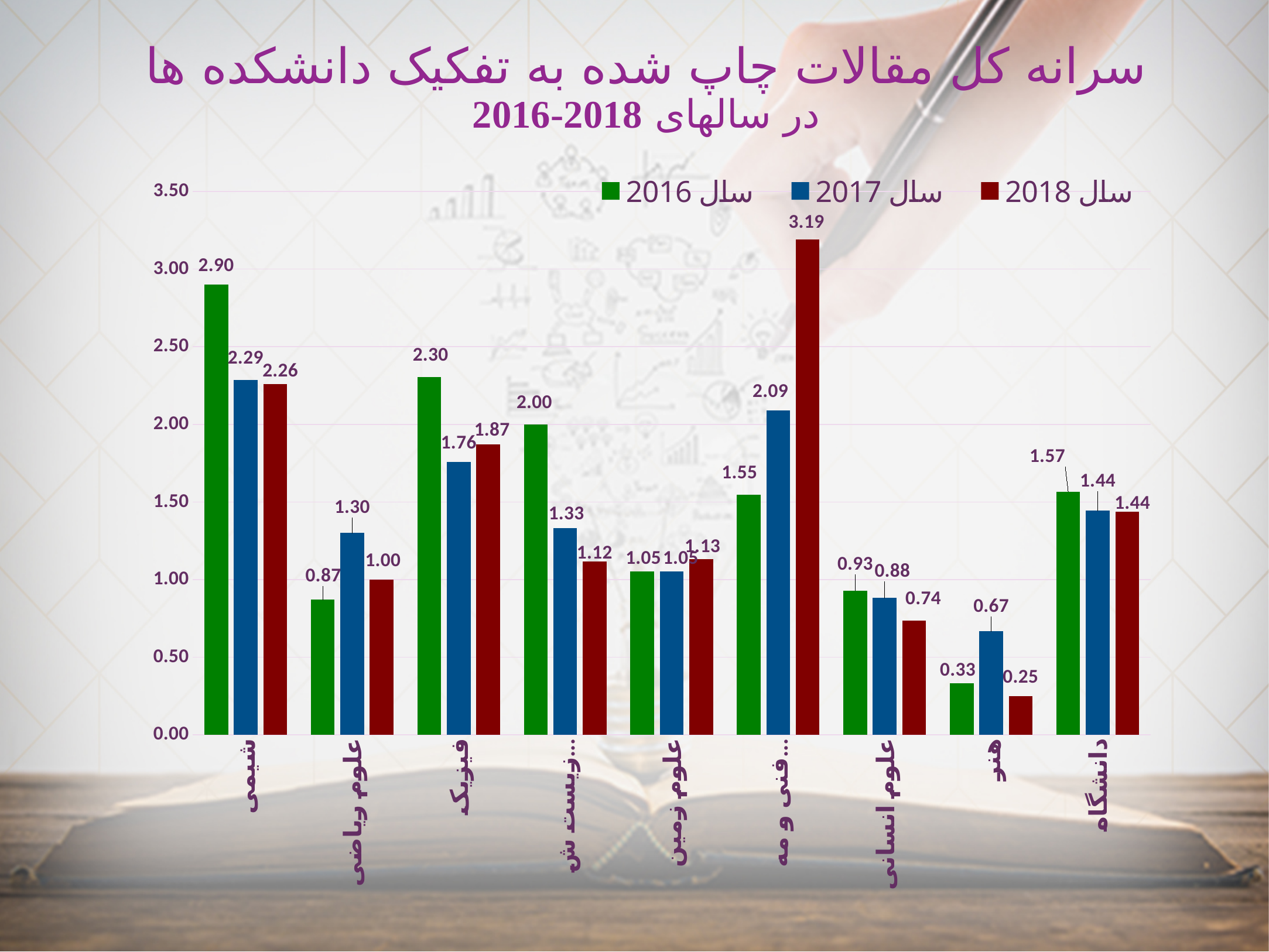
Which category has the highest value in the سال 2016 series? شیمی How many categories are shown on the x axis? 9 What is the difference between the سال 2016 and سال 2018 values for فیزیک? 0.43 Across the three years, do the values for علوم انسانی rise or fall from 2016 to 2018? fall What type of chart is shown on the slide? bar chart What is the value for شیمی in the سال 2016 series? 2.90 What is the value for دانشگاه in the سال 2018 series? 1.44 Which category has the lowest value in the سال 2018 series? هنر How many series does the legend list? 3 For علوم ریاضی, which is larger: the سال 2017 value or the سال 2018 value? سال 2017 What is the value for هنر in the سال 2017 series? 0.67 Which colour represents the سال 2017 series in the legend? blue